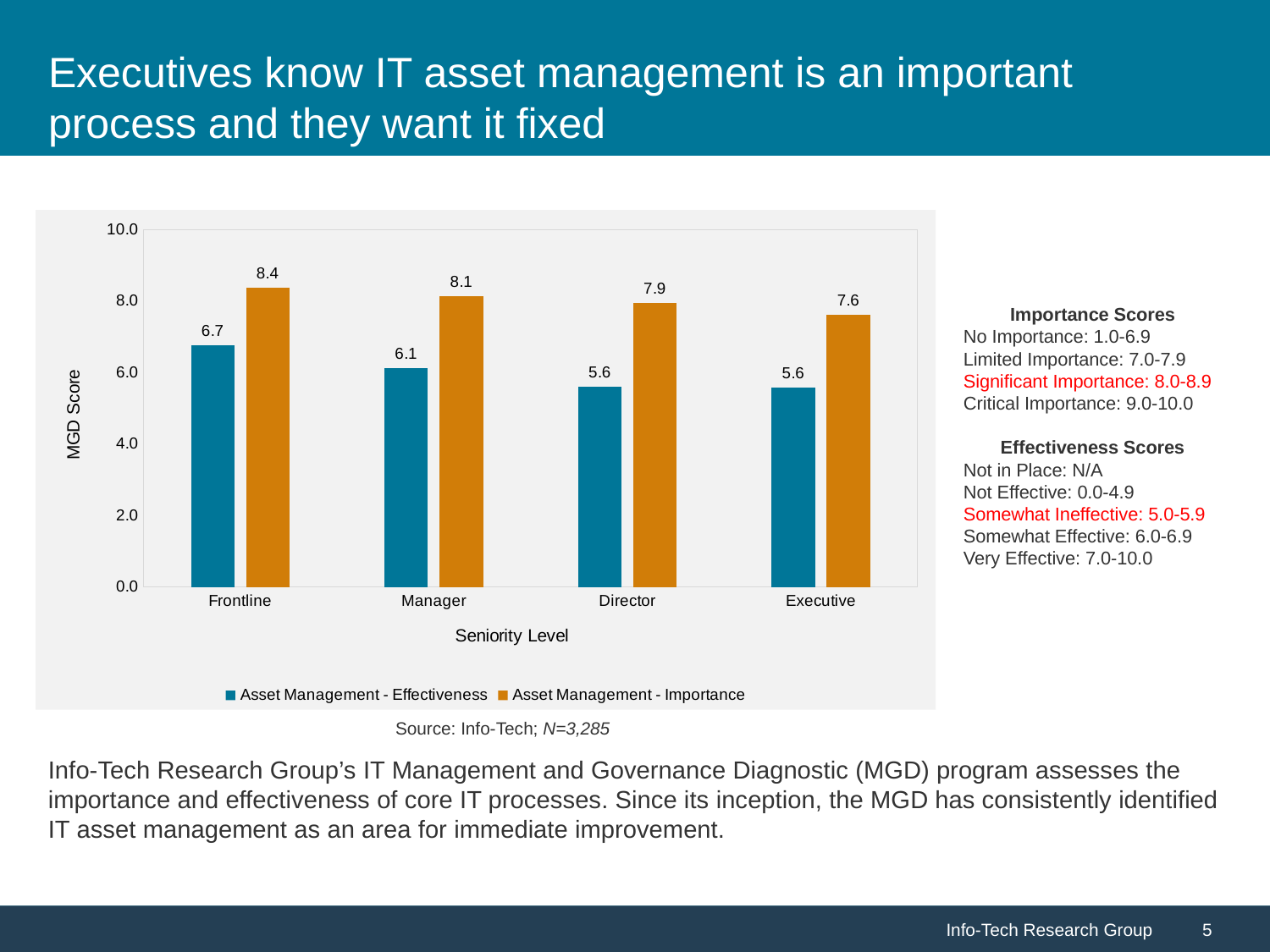
Which seniority level has the highest Asset Management - Importance score? Frontline How many seniority levels are shown on the x axis? 4 What is the difference between the Importance and Effectiveness scores for Director? 2.3 What is the Asset Management - Effectiveness score for Frontline? 6.7 What kind of chart is shown on the slide? Bar chart What is the Asset Management - Importance score for Executive? 7.6 Is the Asset Management - Importance score for Frontline greater or less than 8.0? greater What is the Asset Management - Importance score for Manager? 8.1 Do the Asset Management - Importance scores rise or fall from Frontline to Executive? Fall Which seniority level has the lowest Asset Management - Effectiveness score? Director and Executive How many series does the legend list? 2 Which is larger for Manager: the Effectiveness score or the Importance score? Importance